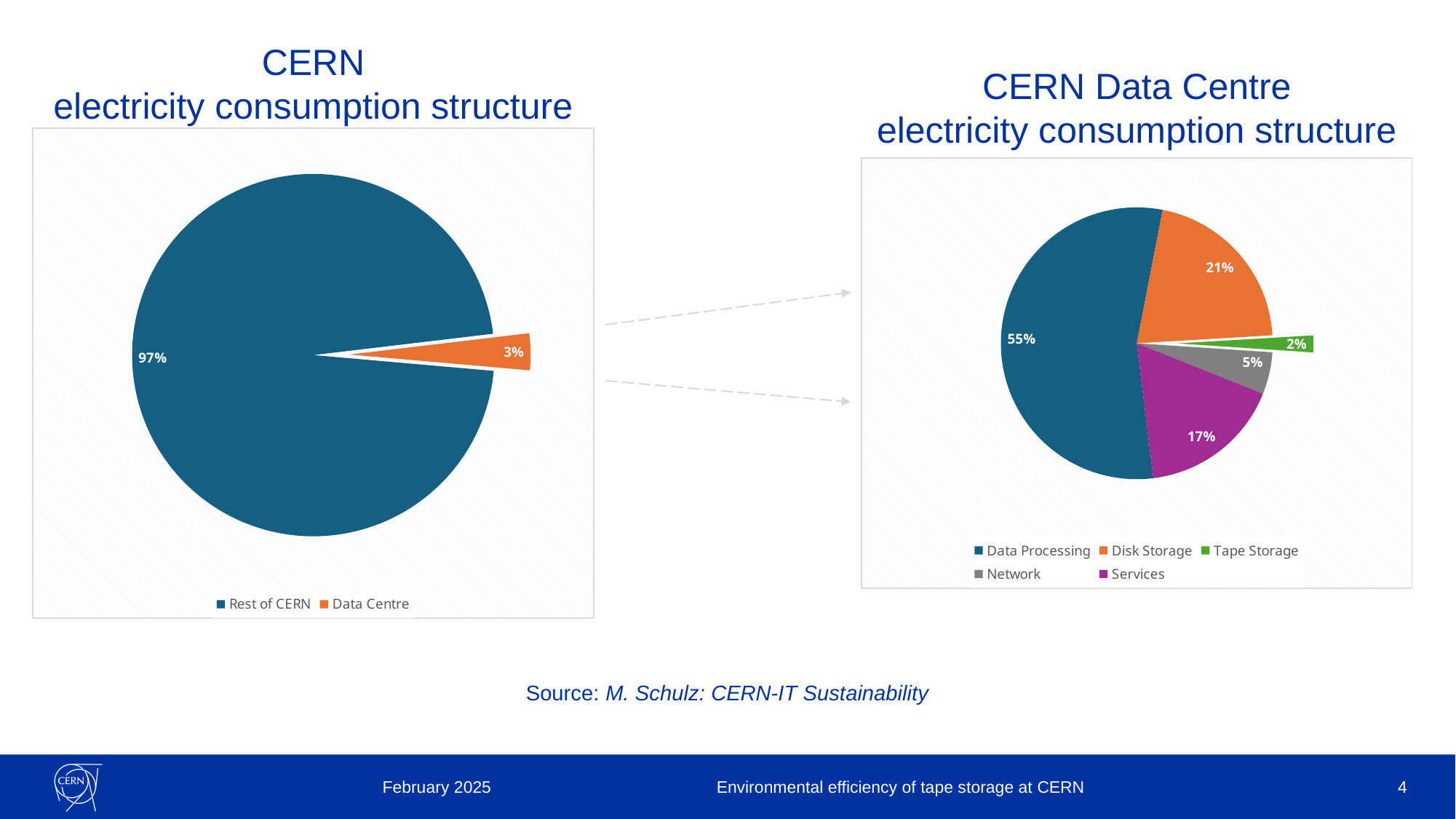
In the 'CERN Data Centre electricity consumption structure' chart, which category has the smallest share? Tape Storage In the 'CERN electricity consumption structure' chart, what share is attributed to Rest of CERN? 97% In the 'CERN Data Centre electricity consumption structure' chart, what share is attributed to Disk Storage? 21% In the 'CERN Data Centre electricity consumption structure' chart, what share is attributed to Tape Storage? 2% In the 'CERN Data Centre electricity consumption structure' chart, which is larger: Services or Network? Services In the 'CERN Data Centre electricity consumption structure' chart, what is the difference between the Disk Storage share and the Tape Storage share? 19 percentage points In the 'CERN electricity consumption structure' chart, what share of electricity consumption is attributed to the Data Centre? 3% What kind of chart is the 'CERN electricity consumption structure' chart on the left? Pie chart How many categories does the legend of the 'CERN Data Centre electricity consumption structure' chart list? 5 How many slices does the 'CERN electricity consumption structure' pie chart have? 2 In the 'CERN Data Centre electricity consumption structure' chart, what share is attributed to Data Processing? 55% In the 'CERN Data Centre electricity consumption structure' chart, which category has the largest share? Data Processing